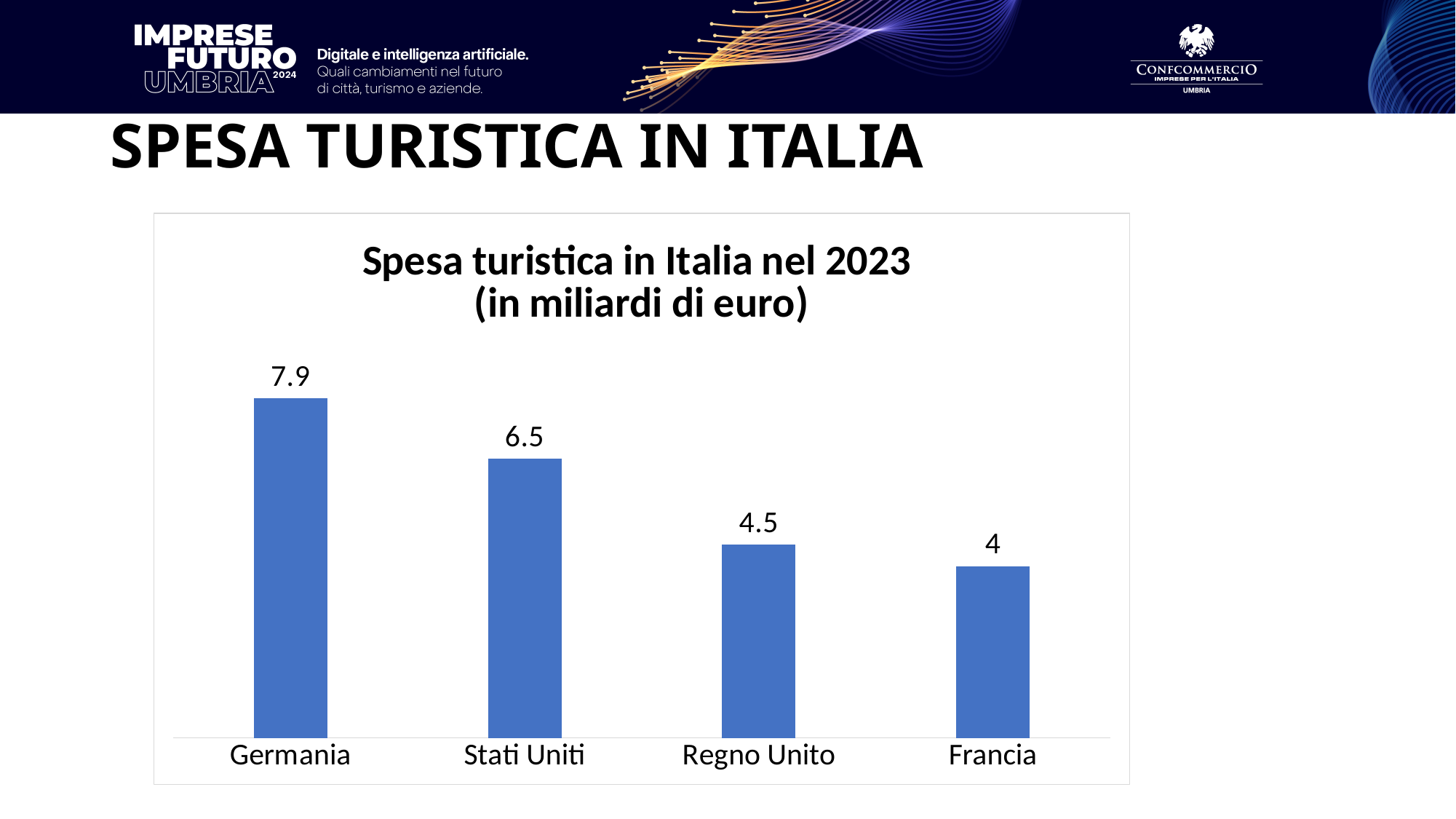
What is the value for Germania? 7.9 What is the value for Stati Uniti? 6.5 What kind of chart is shown on the slide? Bar chart What is the value for Regno Unito? 4.5 What is the difference between the values for Regno Unito and Francia? 0.5 How many countries are shown in the chart? 4 Which country has the highest tourist spending in Italy? Germania Which is larger, the value for Stati Uniti or the value for Regno Unito? Stati Uniti What is the value for Francia? 4 What is the difference between the values for Germania and Stati Uniti? 1.4 Which country has the lowest tourist spending in Italy? Francia What is the title of the chart? Spesa turistica in Italia nel 2023 (in miliardi di euro)